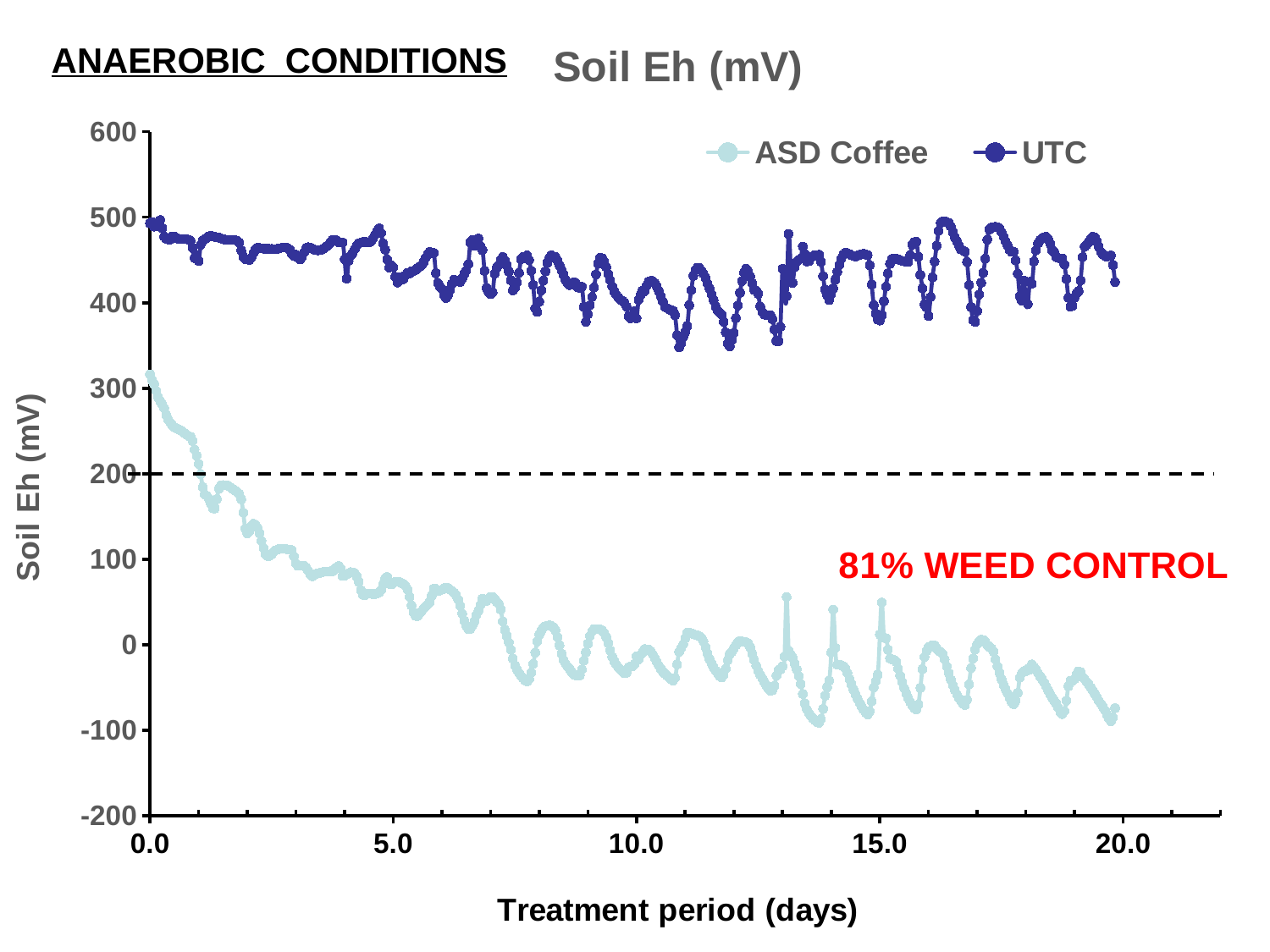
At what Soil Eh level is the horizontal dashed line drawn? 200 Is the value for ASD Coffee at day 5.0 greater or less than 200? less Is the value for UTC at day 15.0 greater or less than 300? greater Which series has the lower Soil Eh values throughout the chart? ASD Coffee How many series does the legend list? 2 What are the two series named in the legend? ASD Coffee and UTC Does the ASD Coffee series rise or fall over the treatment period? Fall Is the value for UTC at day 0.0 greater or less than 400? greater What kind of chart is shown on the slide? Line chart What is the title of the x axis? Treatment period (days) Which series has the higher Soil Eh at day 10.0, ASD Coffee or UTC? UTC